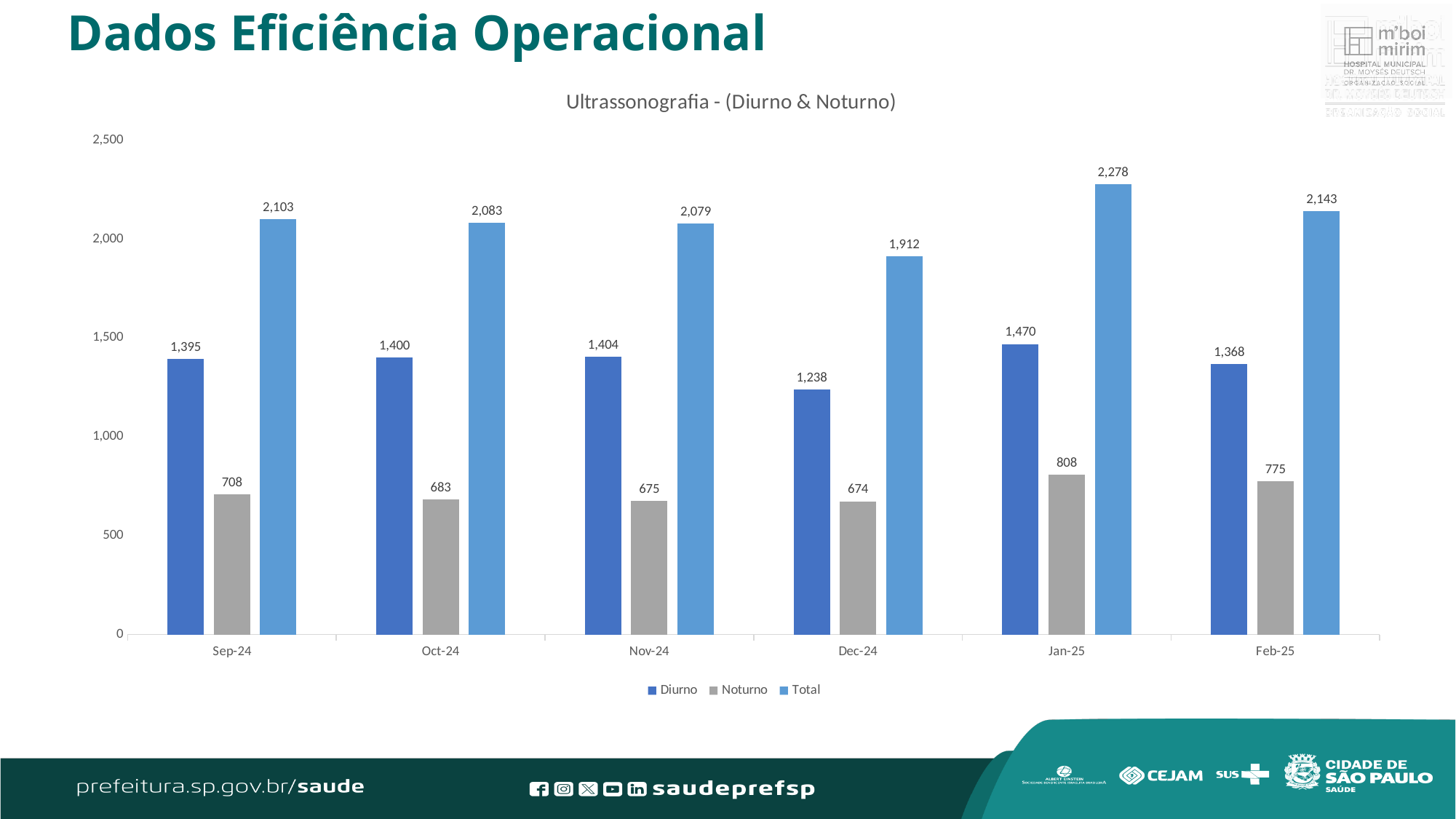
What is the title of the chart? Ultrassonografia - (Diurno & Noturno) Which month has the highest Total value? Jan-25 What is the difference between the Diurno and Noturno values for Feb-25? 593 Which is larger, the Noturno value for Jan-25 or the Noturno value for Feb-25? Jan-25 What is the Noturno value for Sep-24? 708 How many months are shown on the x axis? 6 What kind of chart is shown on the slide? bar chart What is the Diurno value for Dec-24? 1,238 Is the Total value for Dec-24 greater or less than 2,000? less How many series does the legend list? 3 What is the Total value for Jan-25? 2,278 Which month has the lowest Diurno value? Dec-24